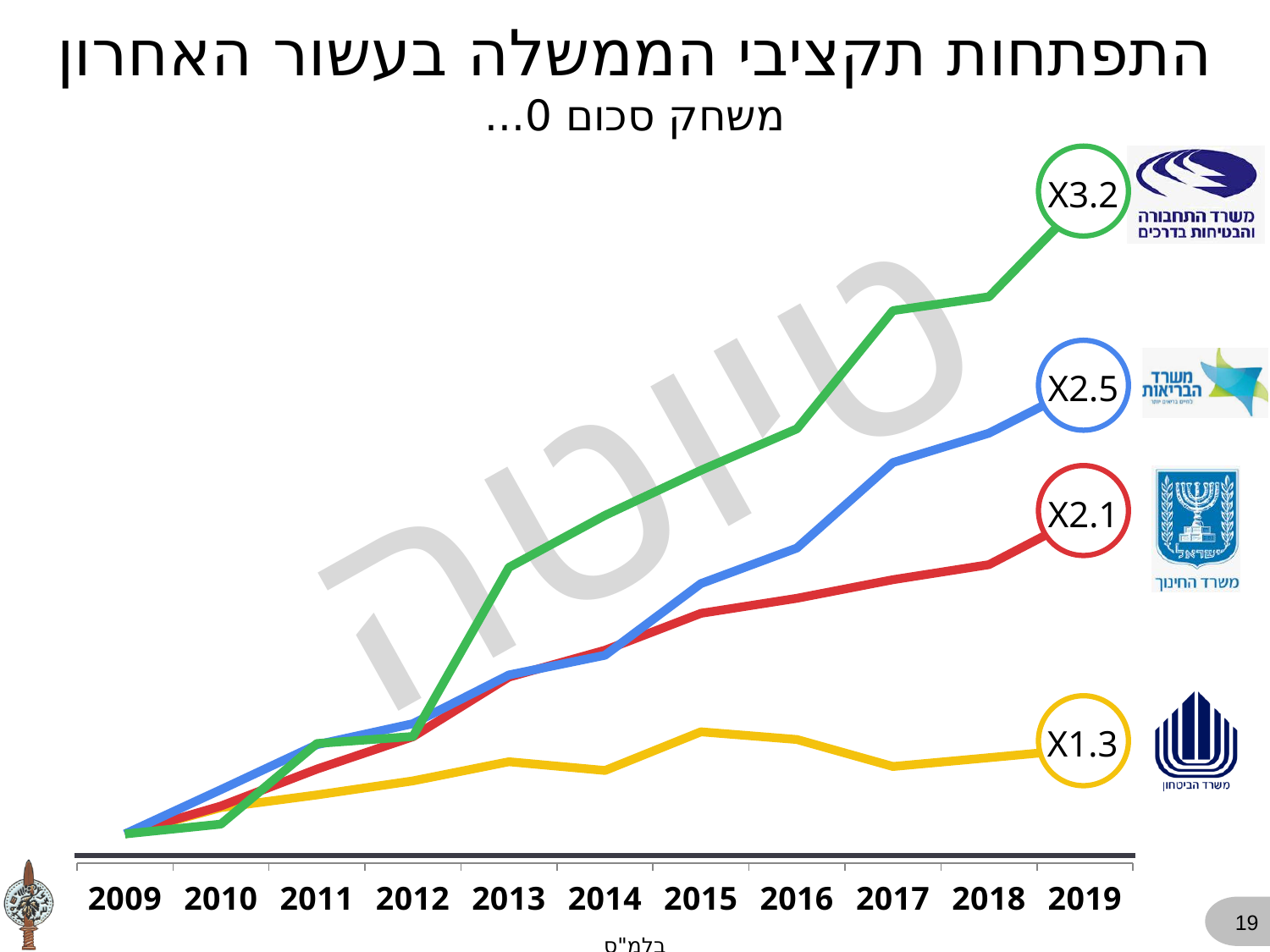
Does the green line generally rise or fall from 2009 to 2019? rise How many lines are plotted on the chart? 4 What is the final value shown for the green line (משרד התחבורה) in 2019? X3.2 How many years are shown on the x axis? 11 Which line has the highest value in 2019? the green line (משרד התחבורה), X3.2 What is the difference between the 2019 values of the green line (X3.2) and the yellow line (X1.3)? 1.9 Which is larger in 2019, the blue line's value or the red line's value? the blue line (X2.5) What kind of chart is shown on the slide? line chart What is the final value shown for the blue line (משרד הבריאות) in 2019? X2.5 What is the final value shown for the yellow line (משרד הביטחון) in 2019? X1.3 Which line has the lowest value in 2019? the yellow line (משרד הביטחון), X1.3 What is the final value shown for the red line (משרד החינוך) in 2019? X2.1